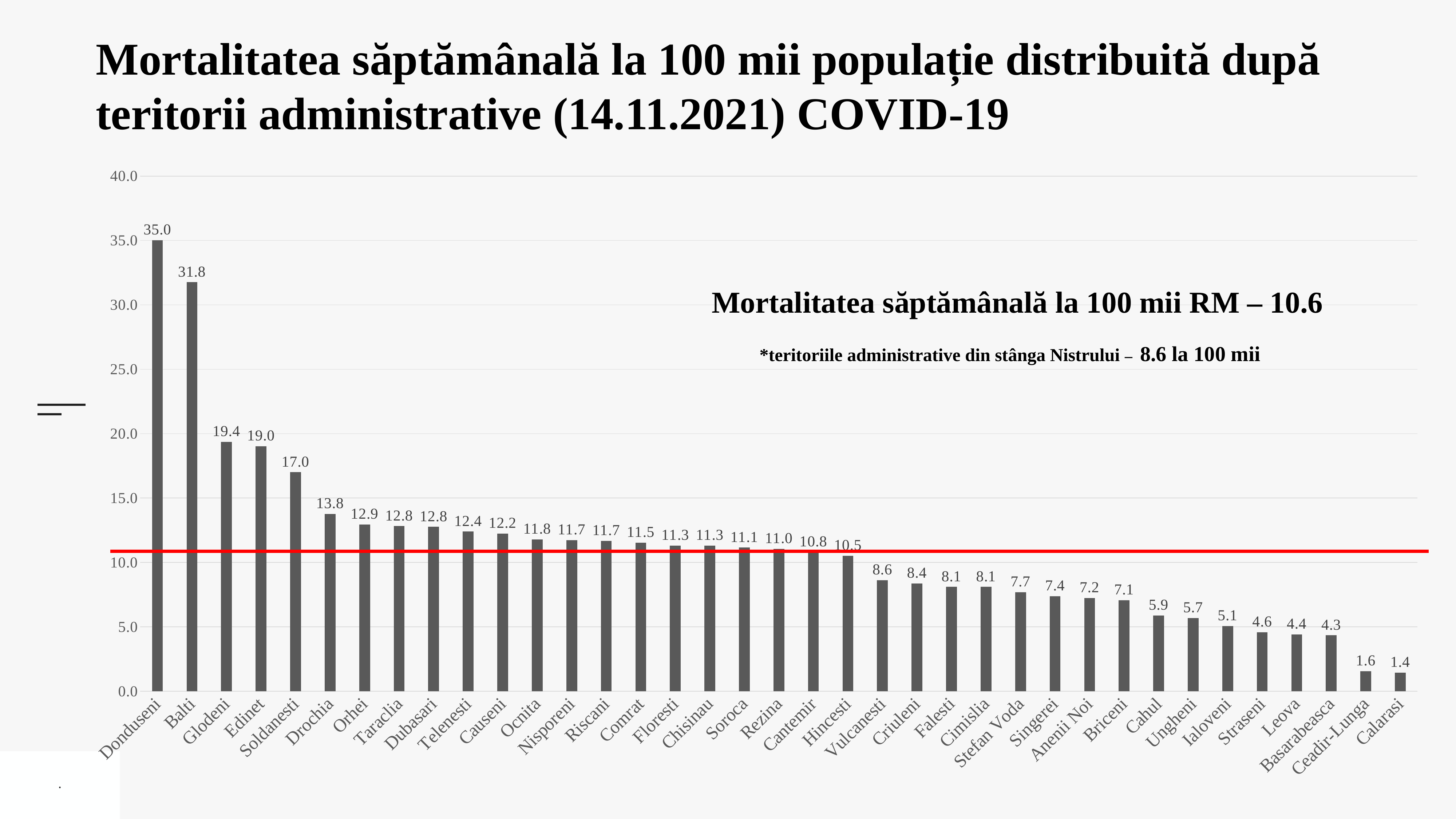
Do the values rise or fall from left to right along the x axis? fall Which territory has the highest weekly mortality? Donduseni Which territory has the lowest weekly mortality? Calarasi Is the value for Drochia greater or less than 15.0? less What kind of chart is shown on the slide? bar chart What national weekly mortality value per 100 thousand (RM) is stated on the slide? 10.6 How many territories are shown on the x axis? 37 Which has a larger value, Glodeni or Soldanesti? Glodeni What is the value shown for Cahul? 5.9 What is the weekly mortality value for Donduseni? 35.0 What is the difference between the values for Donduseni and Balti? 3.2 What is the value shown for Chisinau? 11.3